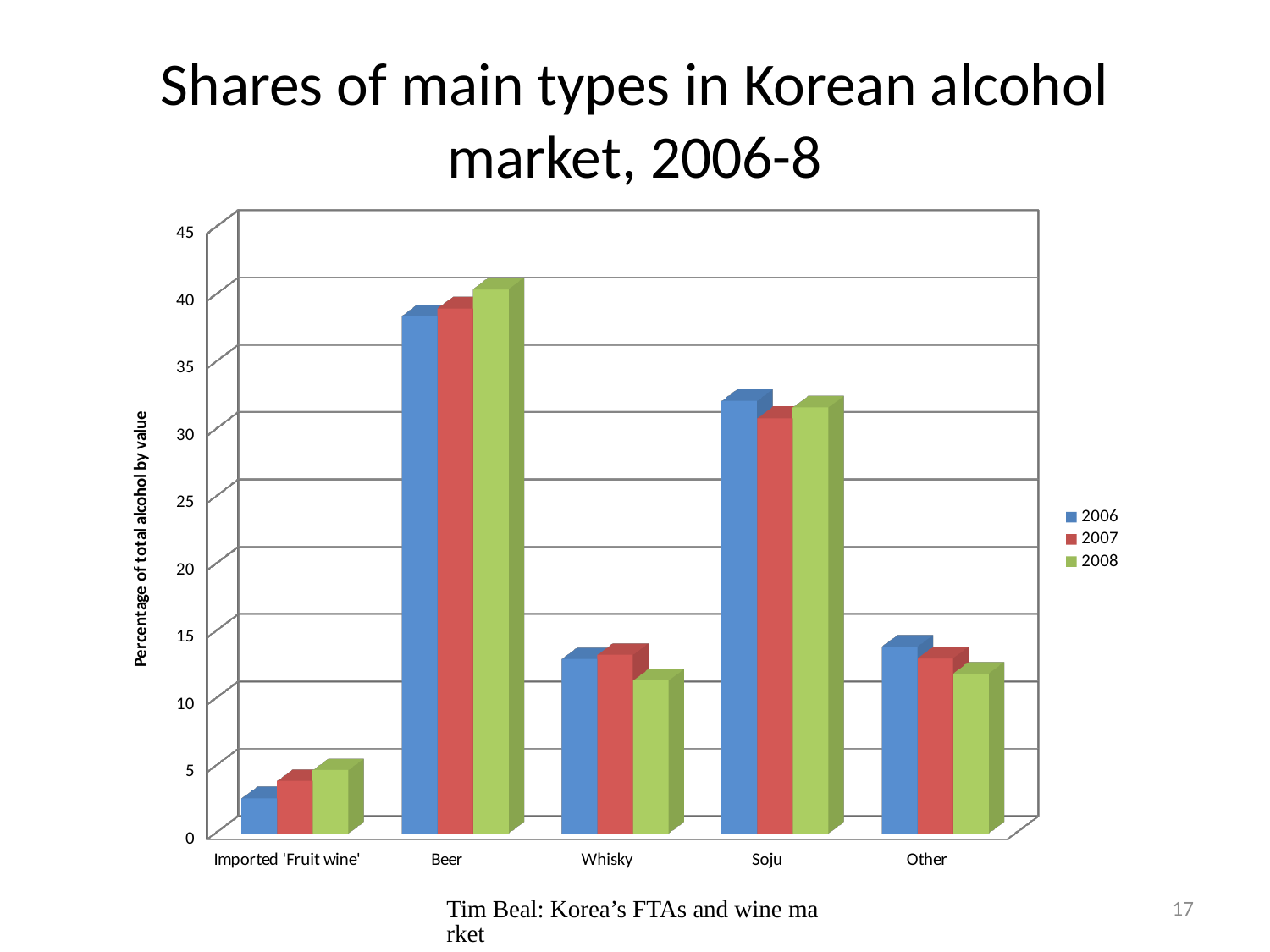
Is the value for Imported 'Fruit wine' in 2006 greater or less than 5? less Which category has the shortest bars in the chart? Imported 'Fruit wine' Is the value for Soju in 2007 greater or less than 35? less Is the value for Whisky in 2008 greater or less than 15? less Which category has the tallest bars in the chart? Beer What is the title of the vertical axis? Percentage of total alcohol by value How many categories are shown on the x axis of the chart? 5 Do the values for Imported 'Fruit wine' rise or fall from 2006 to 2008? rise What type of chart is shown on the slide? Bar chart Which is larger in 2008, the value for Beer or the value for Soju? Beer How many series does the legend list? 3